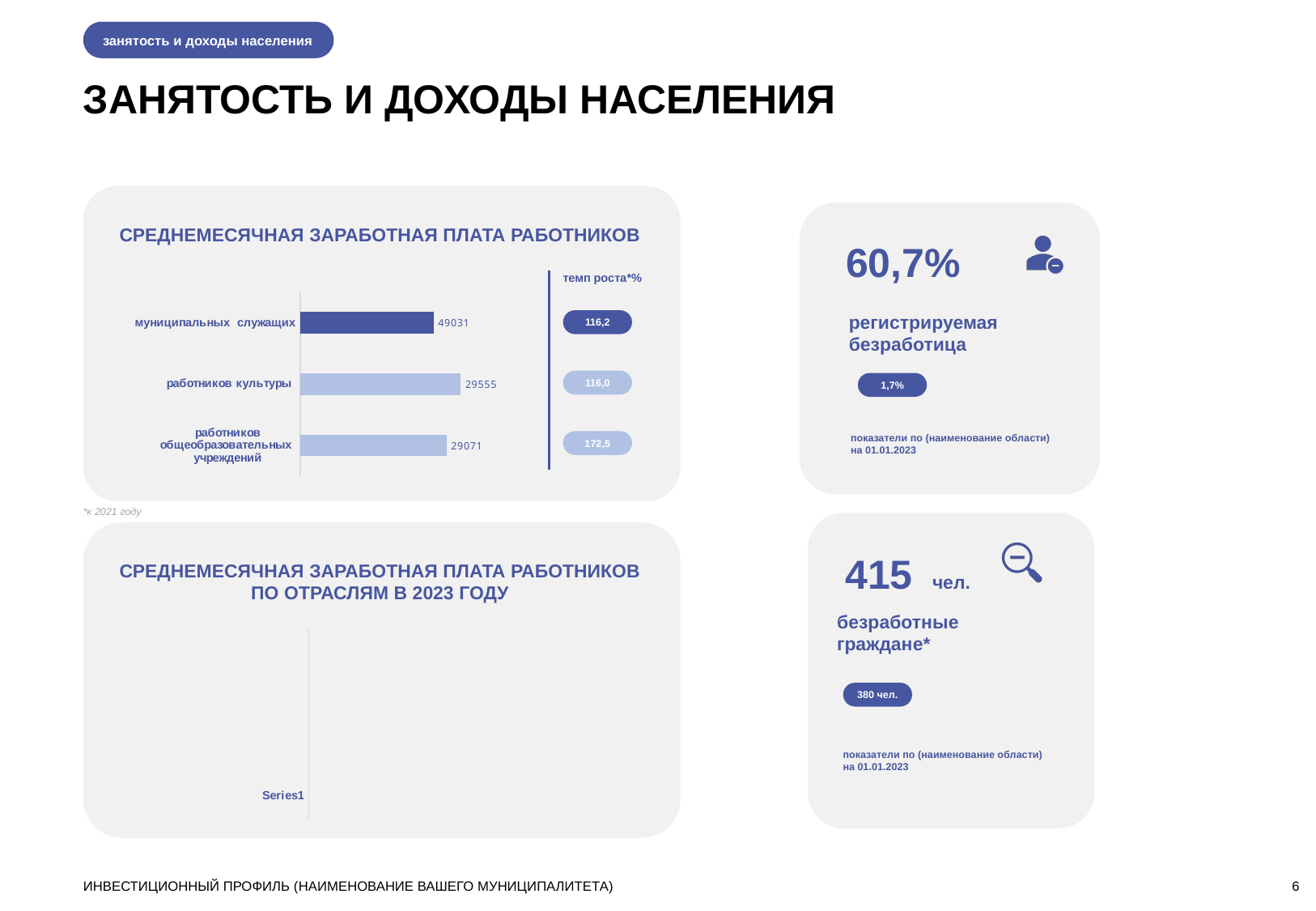
In the chart "СРЕДНЕМЕСЯЧНАЯ ЗАРАБОТНАЯ ПЛАТА РАБОТНИКОВ", what is the темп роста value shown next to работников общеобразовательных учреждений? 172,5 In the chart "СРЕДНЕМЕСЯЧНАЯ ЗАРАБОТНАЯ ПЛАТА РАБОТНИКОВ", what is the difference between the values for муниципальных служащих and работников культуры? 19476 In the chart "СРЕДНЕМЕСЯЧНАЯ ЗАРАБОТНАЯ ПЛАТА РАБОТНИКОВ", what is the value for работников общеобразовательных учреждений? 29071 What is the title of the lower-left chart on the slide? СРЕДНЕМЕСЯЧНАЯ ЗАРАБОТНАЯ ПЛАТА РАБОТНИКОВ ПО ОТРАСЛЯМ В 2023 ГОДУ What kind of chart is "СРЕДНЕМЕСЯЧНАЯ ЗАРАБОТНАЯ ПЛАТА РАБОТНИКОВ"? bar chart How many categories are shown in the chart "СРЕДНЕМЕСЯЧНАЯ ЗАРАБОТНАЯ ПЛАТА РАБОТНИКОВ"? 3 In the chart "СРЕДНЕМЕСЯЧНАЯ ЗАРАБОТНАЯ ПЛАТА РАБОТНИКОВ", what is the value for работников культуры? 29555 In the chart "СРЕДНЕМЕСЯЧНАЯ ЗАРАБОТНАЯ ПЛАТА РАБОТНИКОВ", what is the value for муниципальных служащих? 49031 In the chart "СРЕДНЕМЕСЯЧНАЯ ЗАРАБОТНАЯ ПЛАТА РАБОТНИКОВ", what is the difference between the values for работников культуры and работников общеобразовательных учреждений? 484